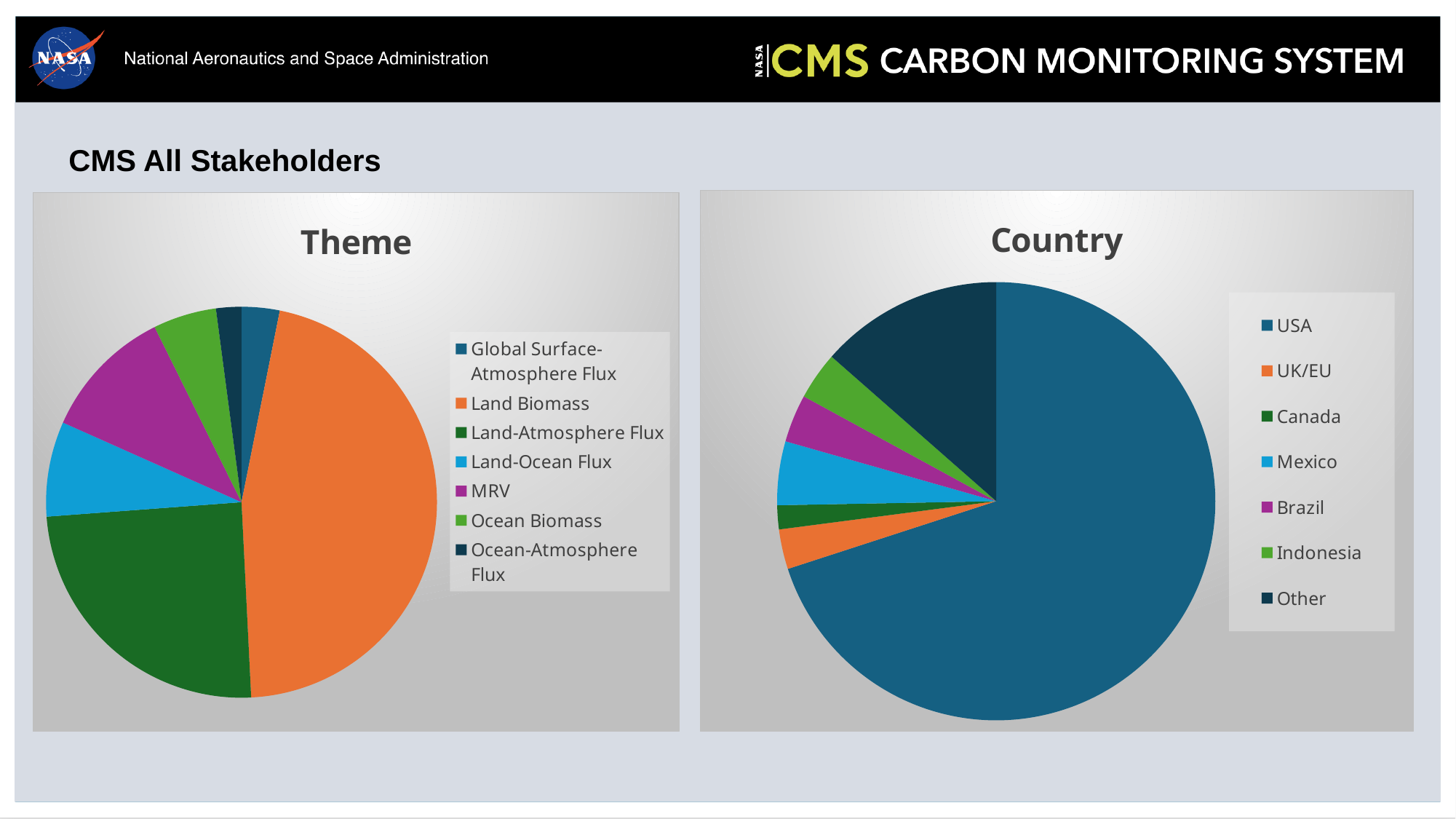
In the Country chart, which country has the largest slice? USA In the Theme chart, which category has the largest slice? Land Biomass What is the title of the chart on the left side of the slide? Theme In the Theme chart, which slice is larger: Land-Atmosphere Flux or MRV? Land-Atmosphere Flux In the Country chart, which slice is larger: Other or Mexico? Other What kind of chart is the Country chart? pie chart In the Country chart, which slice is larger: USA or Other? USA How many categories does the Theme chart's legend list? 7 In the Country chart, which legend entry is shown in orange? UK/EU How many categories does the Country chart's legend list? 7 What kind of chart is the Theme chart? pie chart